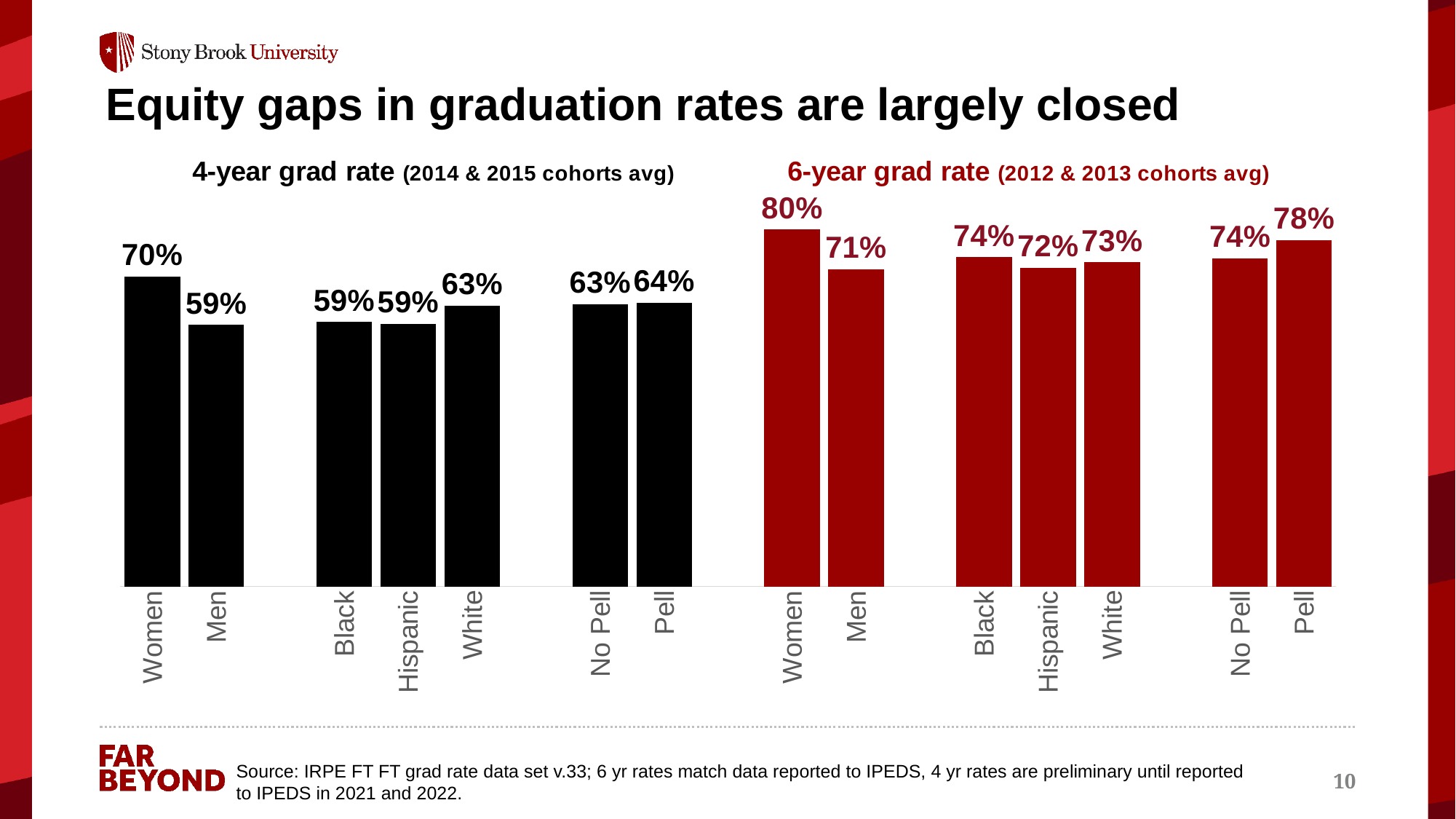
In the 6-year grad rate chart, what is the difference between the values for Pell and No Pell? 4% How many categories are shown in the 4-year grad rate chart? 7 In the 6-year grad rate chart, which category has the highest value? Women In the 4-year grad rate chart, what is the value for White? 63% In the 6-year grad rate chart, which category has the lowest value? Men In the 6-year grad rate chart, which is larger, the value for Black or the value for Hispanic? Black What kind of chart is the 6-year grad rate chart? Bar chart In the 4-year grad rate chart, what is the value for Women? 70% In the 4-year grad rate chart, what is the difference between the values for Women and Men? 11% In the 4-year grad rate chart, which category has the highest value? Women In the 6-year grad rate chart, what is the value for Hispanic? 72% In the 6-year grad rate chart, what is the value for Pell? 78%